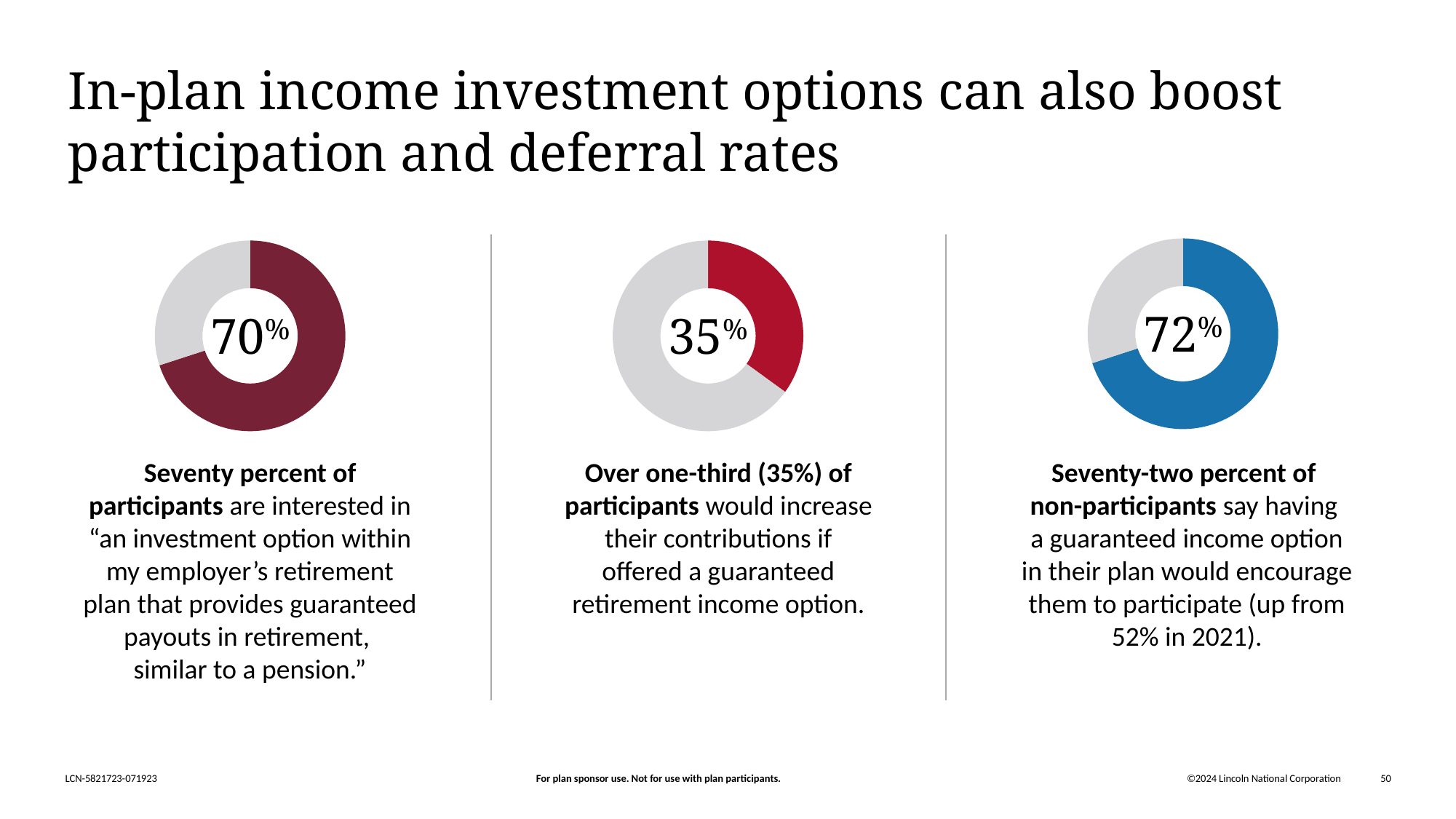
What is the difference between the percentage in the right donut chart and the percentage in the middle donut chart? 37% What value is shown in the centre of the left donut chart? 70% What value is shown in the centre of the right donut chart? 72% Which of the three donut charts shows the highest percentage? The right chart (72%) What is the difference between the percentage in the right donut chart and the percentage in the left donut chart? 2% Is the percentage in the middle donut chart greater or less than 50%? less What kind of chart is used to show the 35% figure? Donut (pie) chart Is the percentage in the left donut chart larger or smaller than the percentage in the middle donut chart? Larger What colour is the filled portion of the right donut chart? Blue How many donut charts are on the slide? 3 Which of the three donut charts shows the lowest percentage? The middle chart (35%) What value is shown in the centre of the middle donut chart? 35%